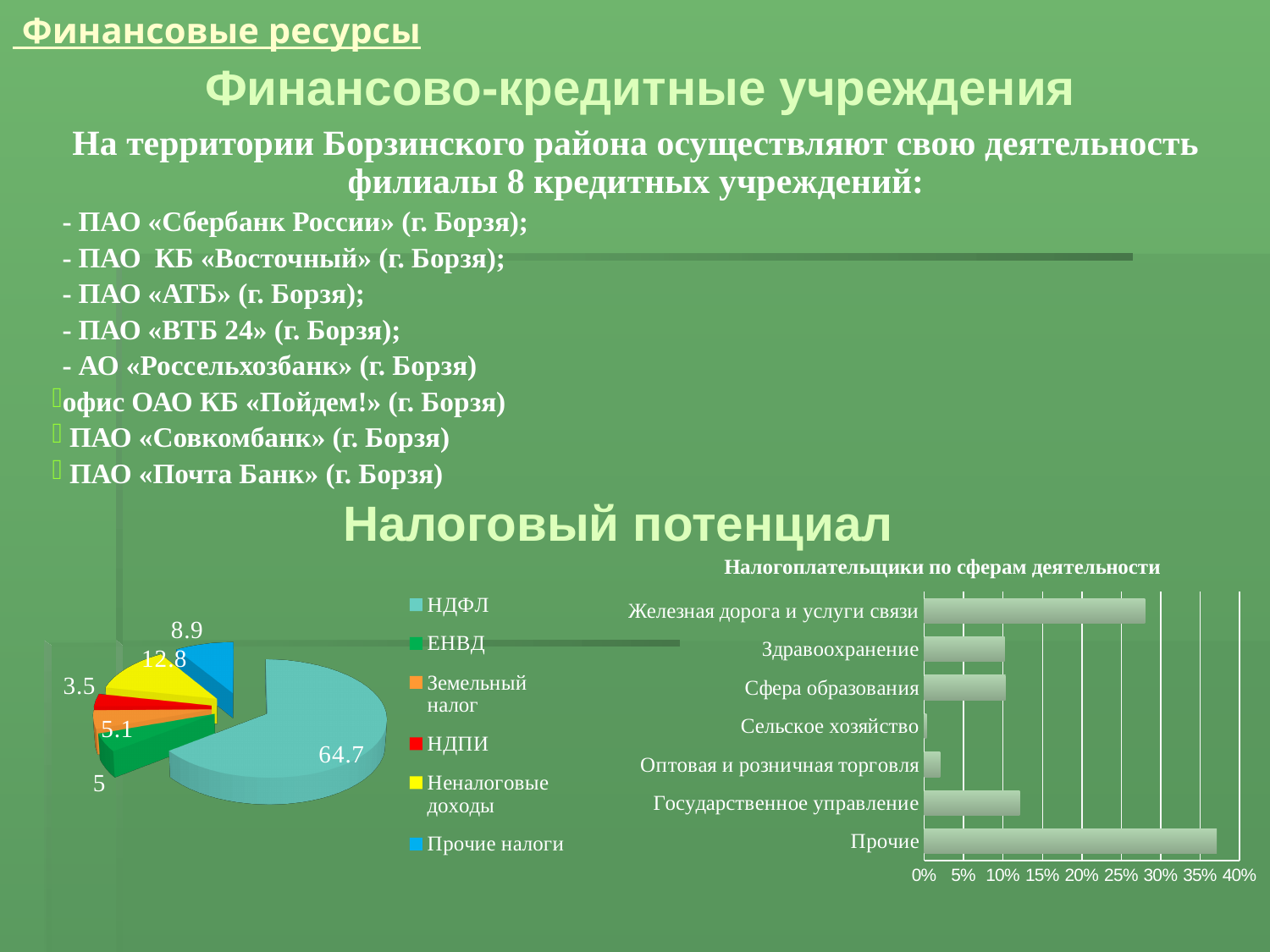
What kind of chart is 'Налогоплательщики по сферам деятельности'? Bar chart What kind of chart is the chart on the left of the slide? Pie chart In the pie chart on the left, what is the value for Неналоговые доходы? 12.8 In the pie chart on the left, which category has the largest slice? НДФЛ How many entries does the legend of the pie chart on the left list? 6 In the pie chart on the left, what is the difference between the values for НДФЛ and Неналоговые доходы? 51.9 In the chart 'Налогоплательщики по сферам деятельности', is the value for Железная дорога и услуги связи greater or less than 25%? greater In the chart 'Налогоплательщики по сферам деятельности', which category has the highest value? Прочие How many categories are shown in the chart 'Налогоплательщики по сферам деятельности'? 7 In the pie chart on the left, what is the value for НДФЛ? 64.7 In the pie chart on the left, which category has the smallest slice? НДПИ In the chart 'Налогоплательщики по сферам деятельности', which category has the lowest value? Сельское хозяйство